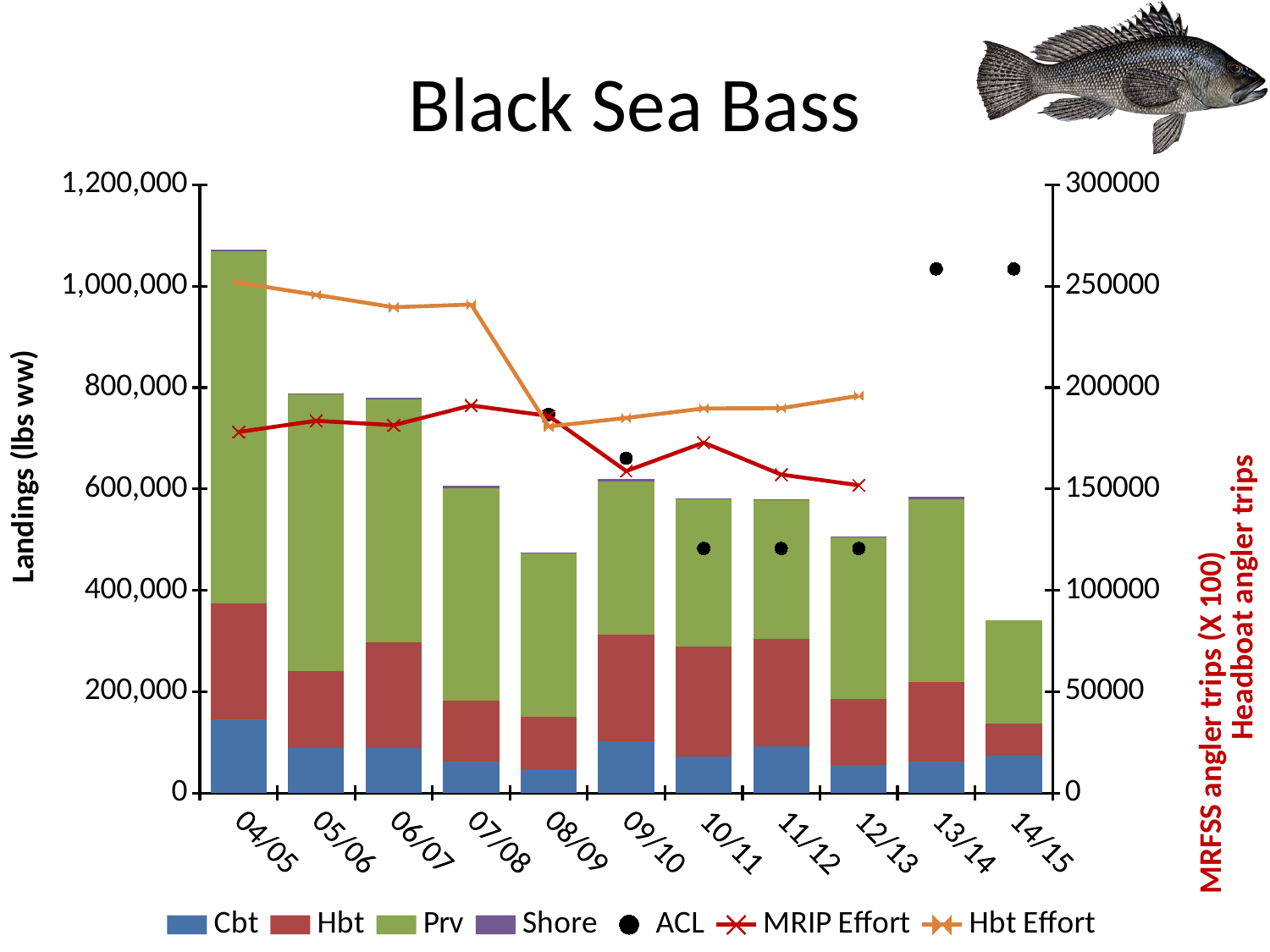
How many fishing years are shown on the x axis of the Black Sea Bass chart? 11 Which fishing year has the lowest total landings in the Black Sea Bass chart? 14/15 How many series does the legend of the Black Sea Bass chart list? 7 Is the total landings value for 04/05 greater or less than 1,000,000 lbs ww? greater Is the Hbt Effort value for 04/05 greater or less than 200000 on the right axis? greater Which year has the highest Hbt Effort value? 04/05 Are total landings larger in 04/05 or in 05/06? 04/05 What is the label of the left vertical axis on the Black Sea Bass chart? Landings (lbs ww) What kind of chart is used to show the landings on the Black Sea Bass slide? bar chart Does the Hbt Effort line rise or fall from 04/05 to 08/09? fall Is the total landings value for 14/15 greater or less than 400,000 lbs ww? less Which fishing year has the highest total landings in the Black Sea Bass chart? 04/05